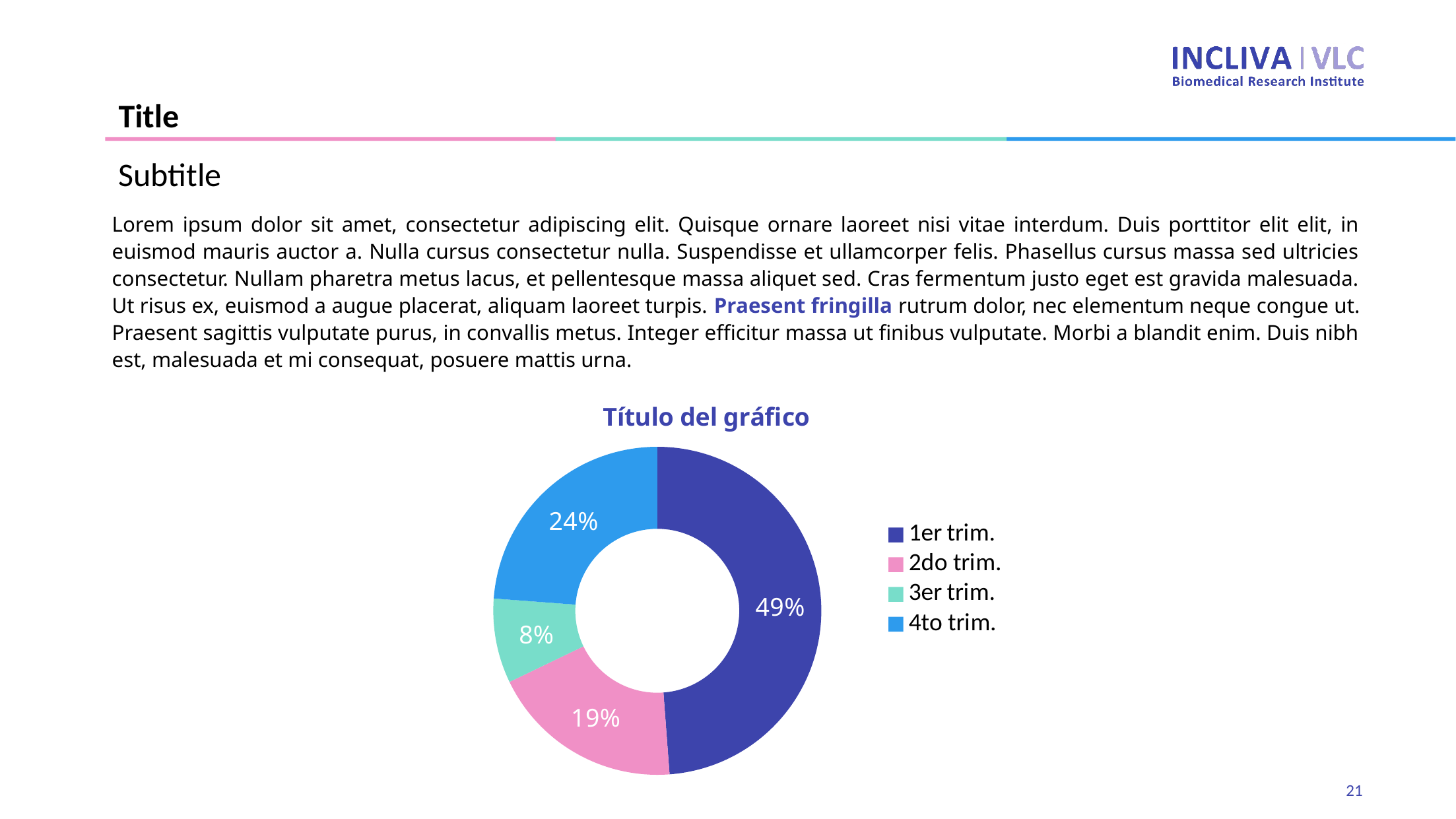
What share of the doughnut chart does 3er trim. represent? 8% What share of the doughnut chart does 4to trim. represent? 24% What is the difference in percentage points between the 1er trim. and 4to trim. slices? 25 How many categories does the chart show? 4 Which slice is larger, 2do trim. or 4to trim.? 4to trim. What kind of chart is shown on the slide? Doughnut chart What share of the doughnut chart does 2do trim. represent? 19% What is the title of the chart? Título del gráfico Which category has the smallest slice in the chart? 3er trim. Which colour represents 2do trim. in the chart legend? Pink Which category has the largest slice in the chart? 1er trim.